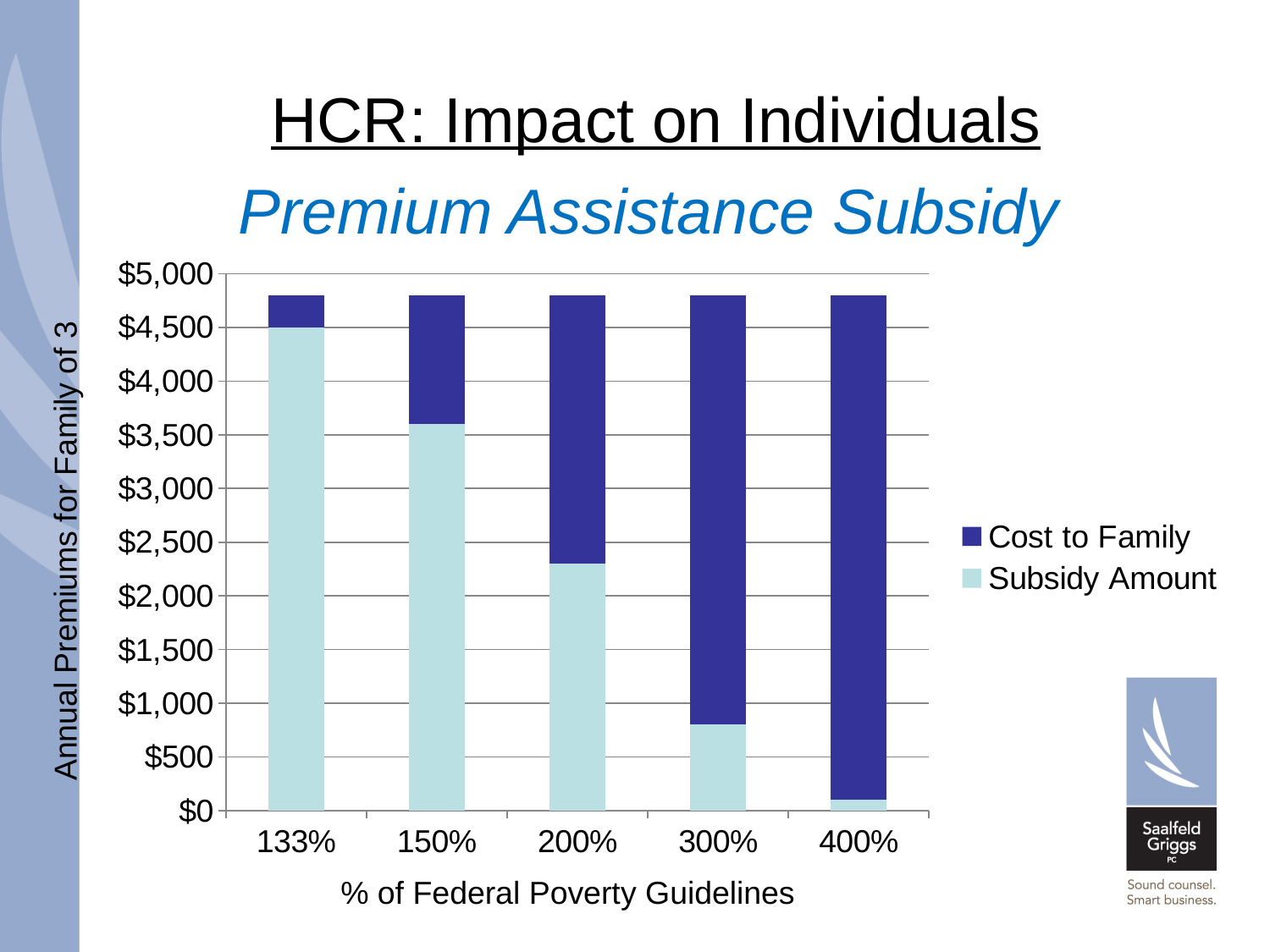
Which category has the highest Cost to Family? 400% Is the Subsidy Amount at 400% greater or less than $500? less How many series does the chart's legend list? 2 How many categories are shown on the x axis of the chart? 5 Which is larger, the Subsidy Amount at 150% or at 200%? 150% Is the Subsidy Amount at 300% greater or less than $1,000? less Does the Subsidy Amount rise or fall as the % of Federal Poverty Guidelines increases along the x axis? Fall What is the title of the chart's y axis? Annual Premiums for Family of 3 Which category has the lowest Subsidy Amount? 400% What kind of chart is shown on the slide? Stacked bar chart Which category has the highest Subsidy Amount? 133% Is the Subsidy Amount at 150% greater or less than $3,500? greater